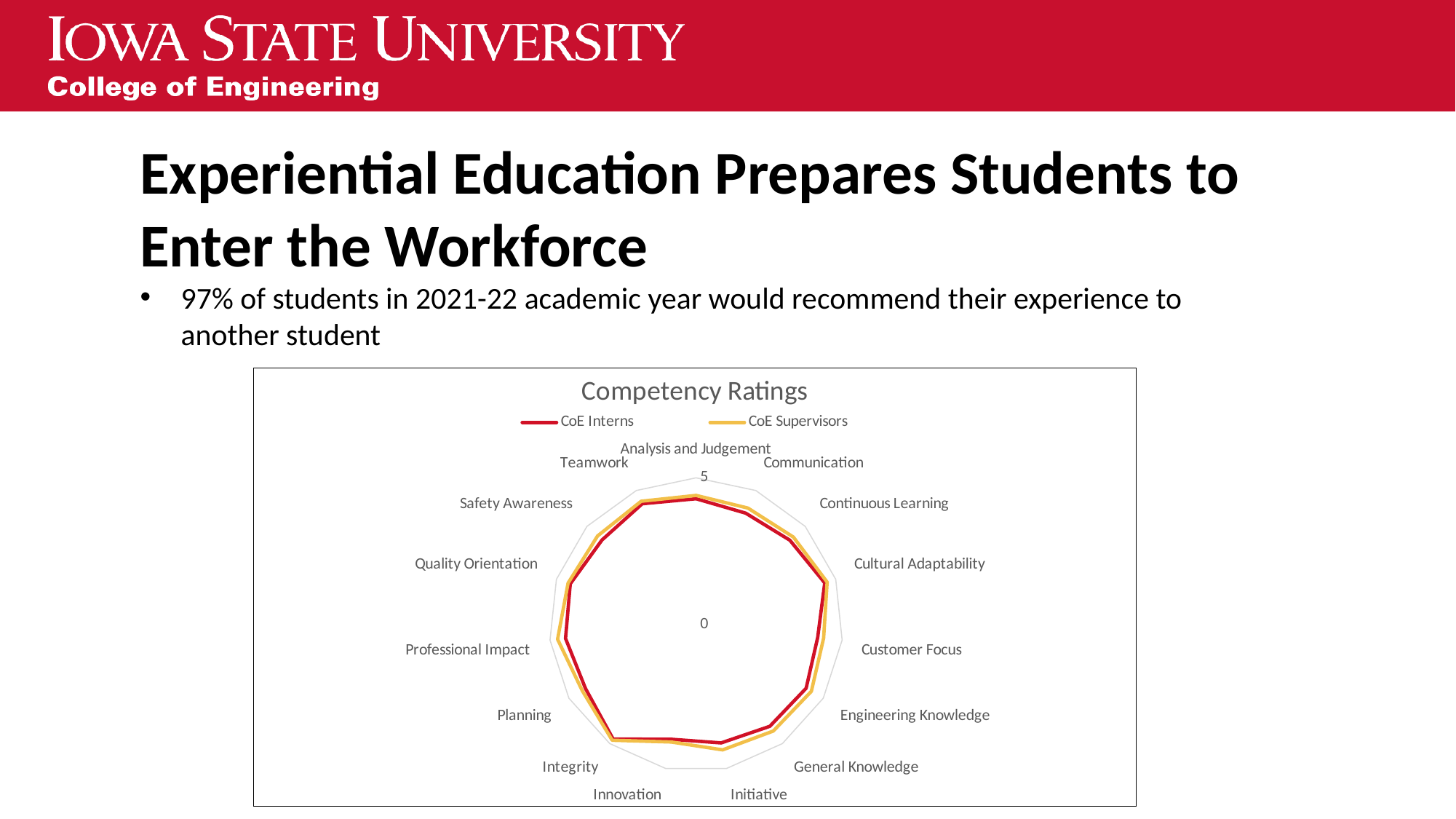
Is the CoE Interns value for Safety Awareness greater or less than 0? greater What is the title of the chart on the slide? Competency Ratings Is the CoE Interns value for Teamwork greater or less than 0? greater Which series in the Competency Ratings chart is drawn in red? CoE Interns Is the CoE Supervisors value for Integrity greater or less than 5? less How many competency categories are plotted on the Competency Ratings chart? 15 How many series does the legend of the Competency Ratings chart list? 2 What kind of chart is shown on the slide? Radar chart